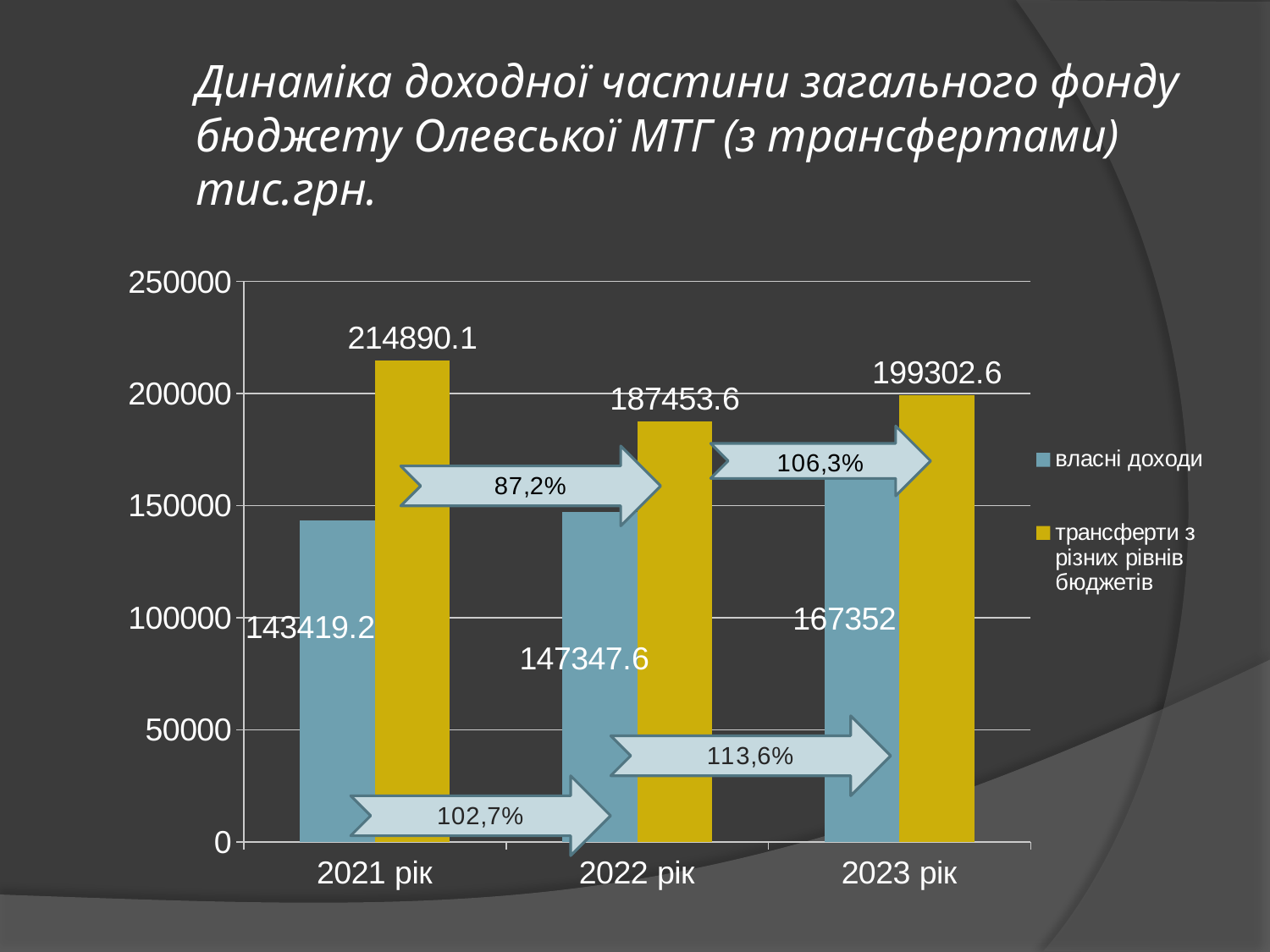
How many series does the legend list? 2 Is the value of трансферти з різних рівнів бюджетів for 2021 рік greater or less than 200000? greater Do the values of власні доходи rise or fall from 2021 рік to 2023 рік? rise In which year is the value of трансферти з різних рівнів бюджетів the highest? 2021 рік What is the difference between трансферти з різних рівнів бюджетів and власні доходи in 2023 рік? 31950.6 What is the value of трансферти з різних рівнів бюджетів for 2022 рік? 187453.6 What is the value of власні доходи for 2021 рік? 143419.2 How many years are shown on the x axis? 3 What is the value of власні доходи for 2023 рік? 167352 In which year is the value of власні доходи the lowest? 2021 рік Which is larger in 2022 рік: власні доходи or трансферти з різних рівнів бюджетів? трансферти з різних рівнів бюджетів What kind of chart is shown on the slide? bar chart